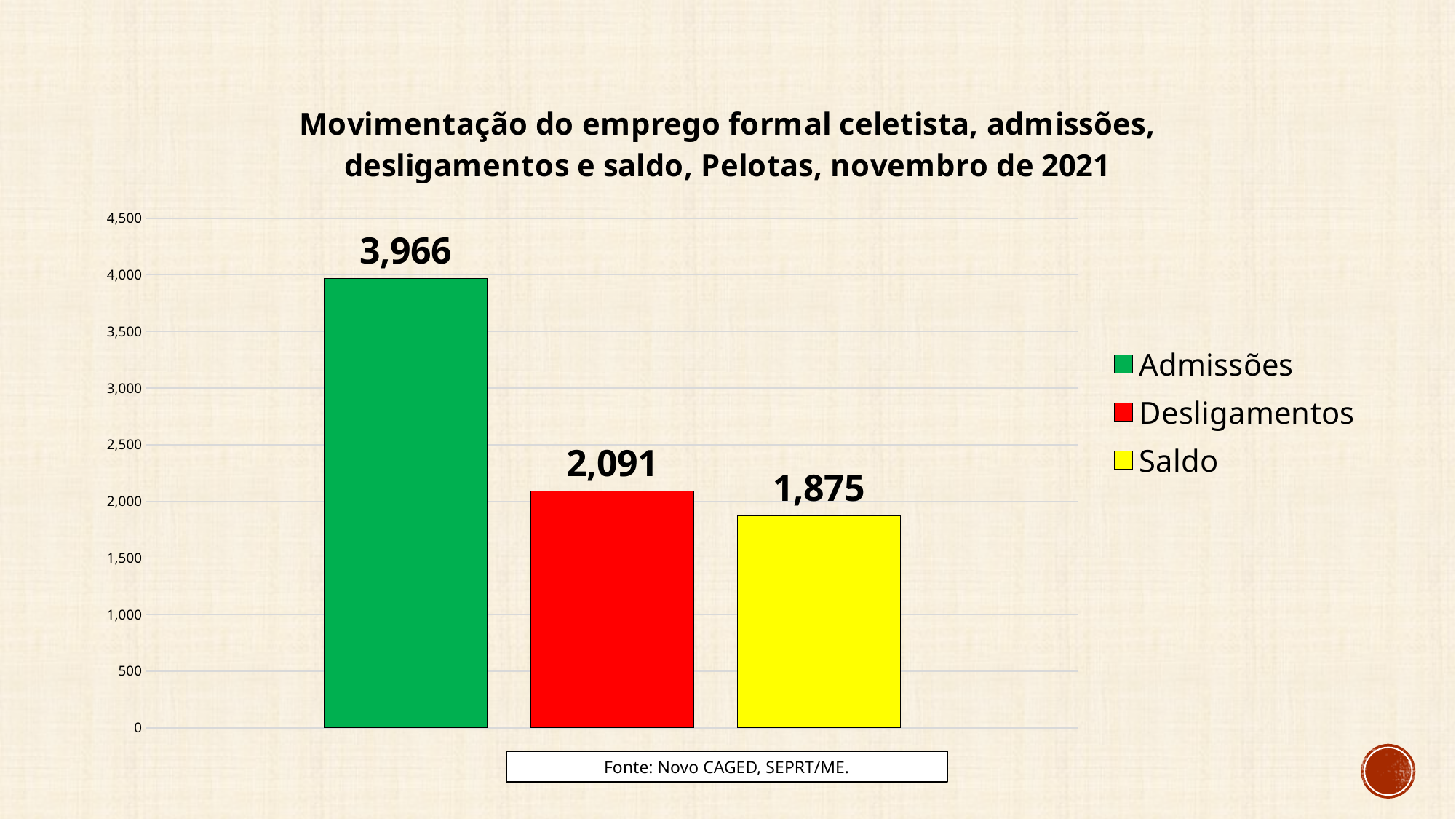
What is the value for Admissões? 3,966 Which is larger, Desligamentos or Saldo? Desligamentos Which series has the highest value? Admissões What is the value for Saldo? 1,875 What is the value for Desligamentos? 2,091 What is the difference between Admissões and Desligamentos? 1,875 Which series has the lowest value? Saldo Is the value for Saldo greater or less than 2,000? less What is the difference between Desligamentos and Saldo? 216 What kind of chart is shown on the slide? bar chart What colour is the bar for Desligamentos? red How many series does the legend list? 3